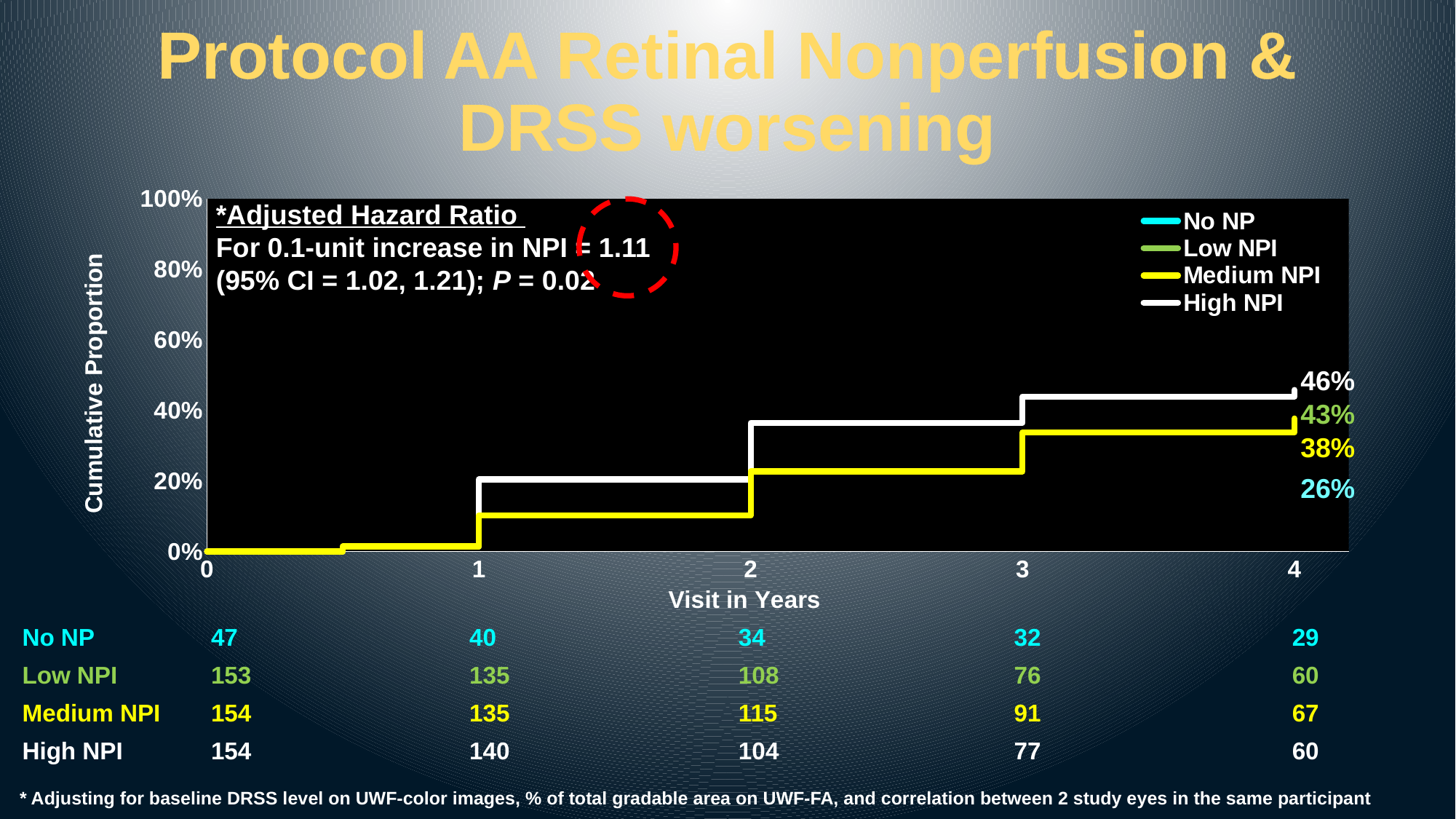
What kind of chart is shown? Line chart Is the value for Medium NPI at year 1 greater or less than 20%? less What is the cumulative proportion for Medium NPI at year 4? 38% What is the cumulative proportion for High NPI at year 4? 46% What is the cumulative proportion for No NP at year 4? 26% Do the plotted cumulative proportions rise or fall as visit years increase? Rise At year 4, which is larger: the cumulative proportion for Low NPI or for Medium NPI? Low NPI How many series does the legend list? 4 What is the label of the y axis? Cumulative Proportion What is the difference between the year-4 cumulative proportions of High NPI and Medium NPI? 8% Which group has the lowest cumulative proportion at year 4? No NP Which group has the highest cumulative proportion at year 4? High NPI